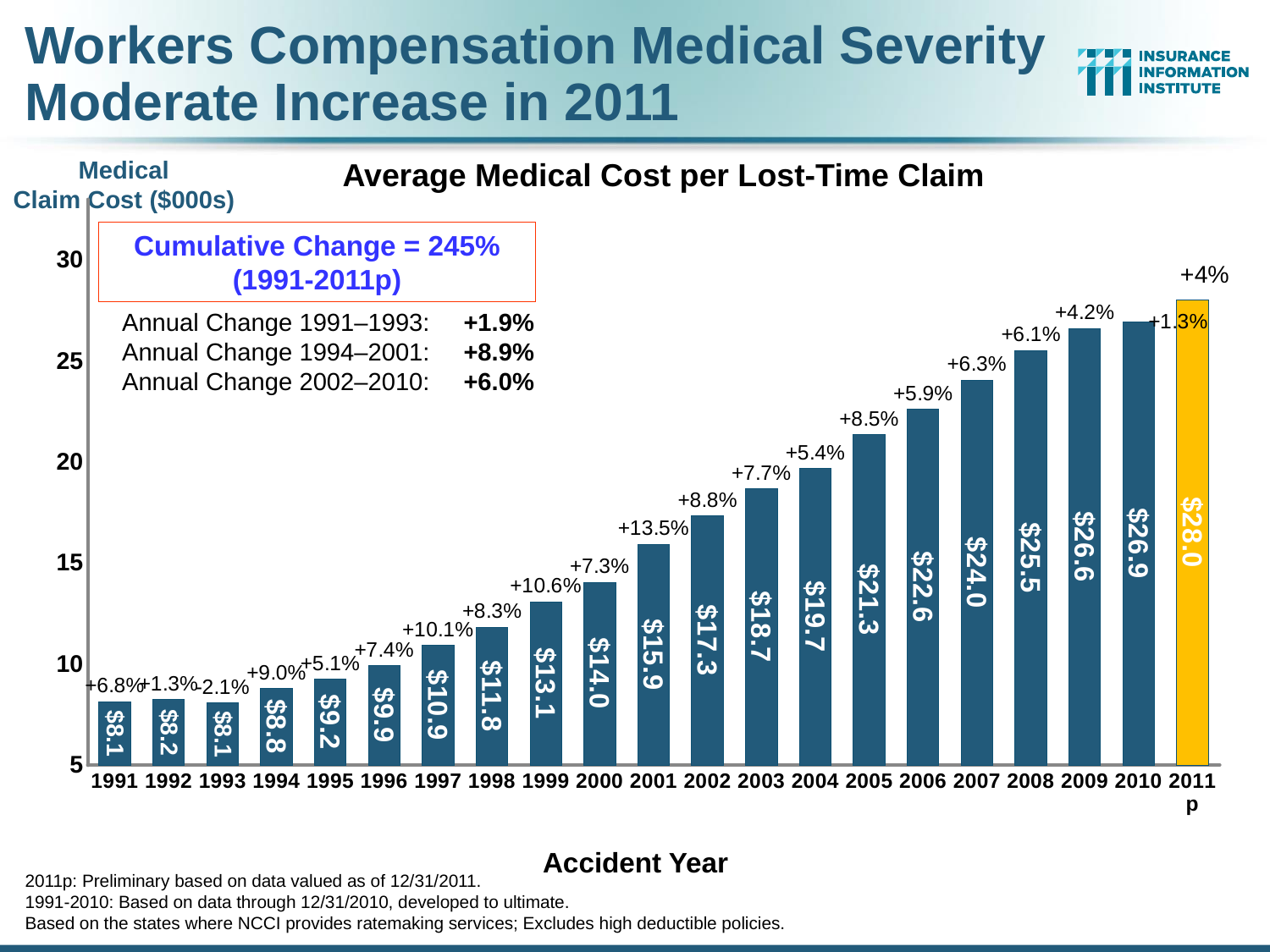
How many accident years are plotted on the chart? 21 What cumulative change from 1991 to 2011p is stated on the chart? 245% Which accident year has the highest average medical cost per lost-time claim? 2011p What is the value shown for accident year 1997? $10.9 Which accident year has a larger value, 2003 or 2006? 2006 What percentage change is labeled above the 2001 bar? +13.5% What is the difference between the values for 2011p and 2010? $1.1 Do the values generally rise or fall from 1991 to 2011p? rise What is the average medical cost per lost-time claim for accident year 2005? $21.3 What is the lowest average medical cost per lost-time claim shown on the chart? $8.1 What type of chart is shown on the slide? bar chart What is the value shown for accident year 2011p? $28.0